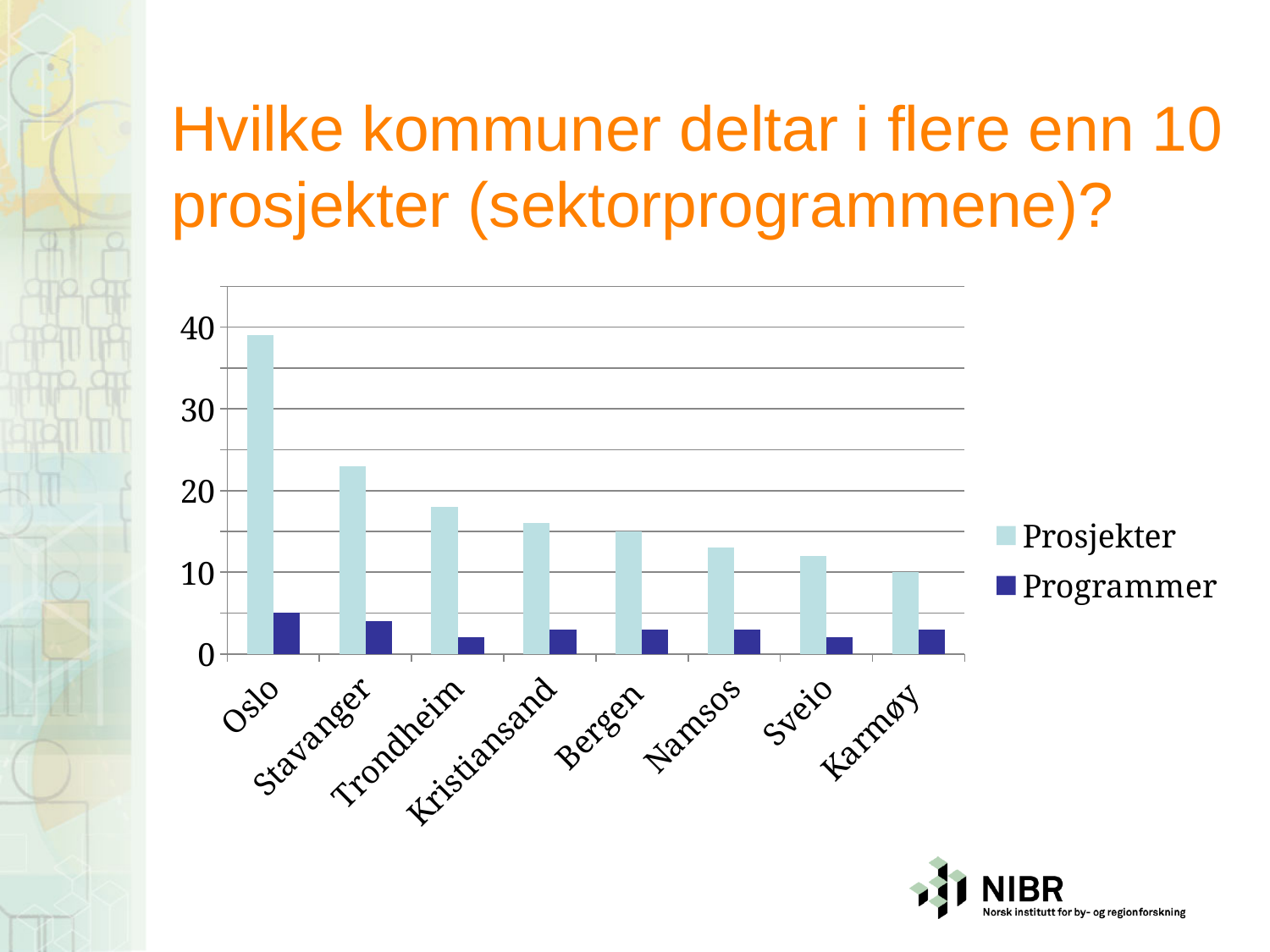
Is the Prosjekter value for Bergen greater or less than 20? less Do the Prosjekter values rise or fall from Oslo to Karmøy along the x axis? fall What are the two series named in the legend? Prosjekter and Programmer Which has a larger Prosjekter value, Oslo or Stavanger? Oslo How many municipalities (categories) are shown on the x axis? 8 Which municipality has the highest Programmer value? Oslo Which municipality has the highest Prosjekter value? Oslo Which municipality has the lowest Prosjekter value? Karmøy How many series does the legend list? 2 What kind of chart is shown on the slide? bar chart Is the Prosjekter value for Oslo greater or less than 30? greater Is the Prosjekter value for Stavanger greater or less than 20? greater